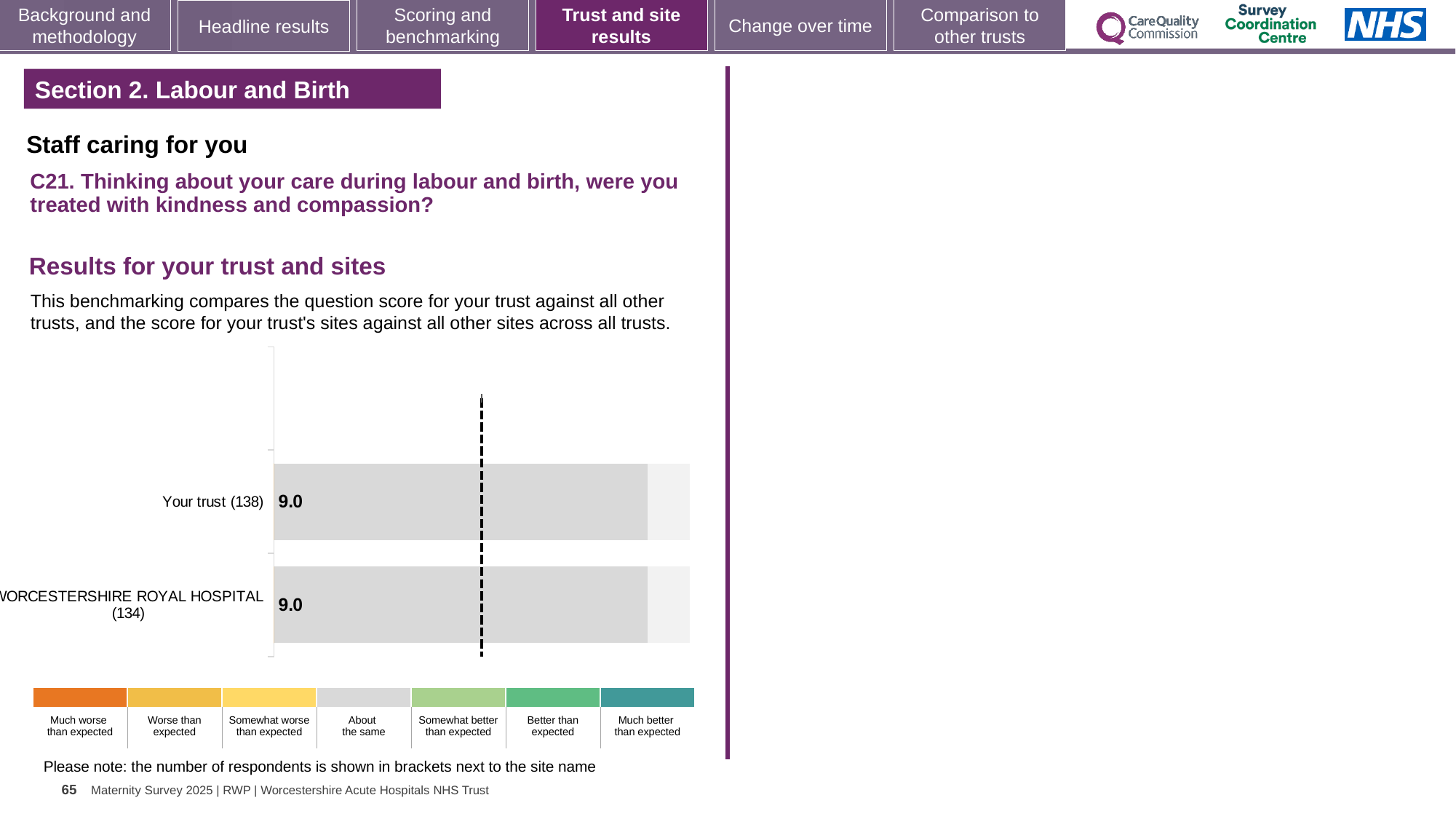
Which benchmark category does the grey colour of the bars correspond to in the colour key? About the same Is the score for Your trust (138) higher than, lower than, or equal to the score for WORCESTERSHIRE ROYAL HOSPITAL (134)? Equal How many respondents are shown in brackets for Your trust? 138 What kind of chart is shown on the slide? Bar chart How many bars are plotted in the chart? 2 What is the score for WORCESTERSHIRE ROYAL HOSPITAL (134)? 9.0 What is the score for Your trust (138)? 9.0 What is the difference between the score for Your trust (138) and the score for WORCESTERSHIRE ROYAL HOSPITAL (134)? 0.0